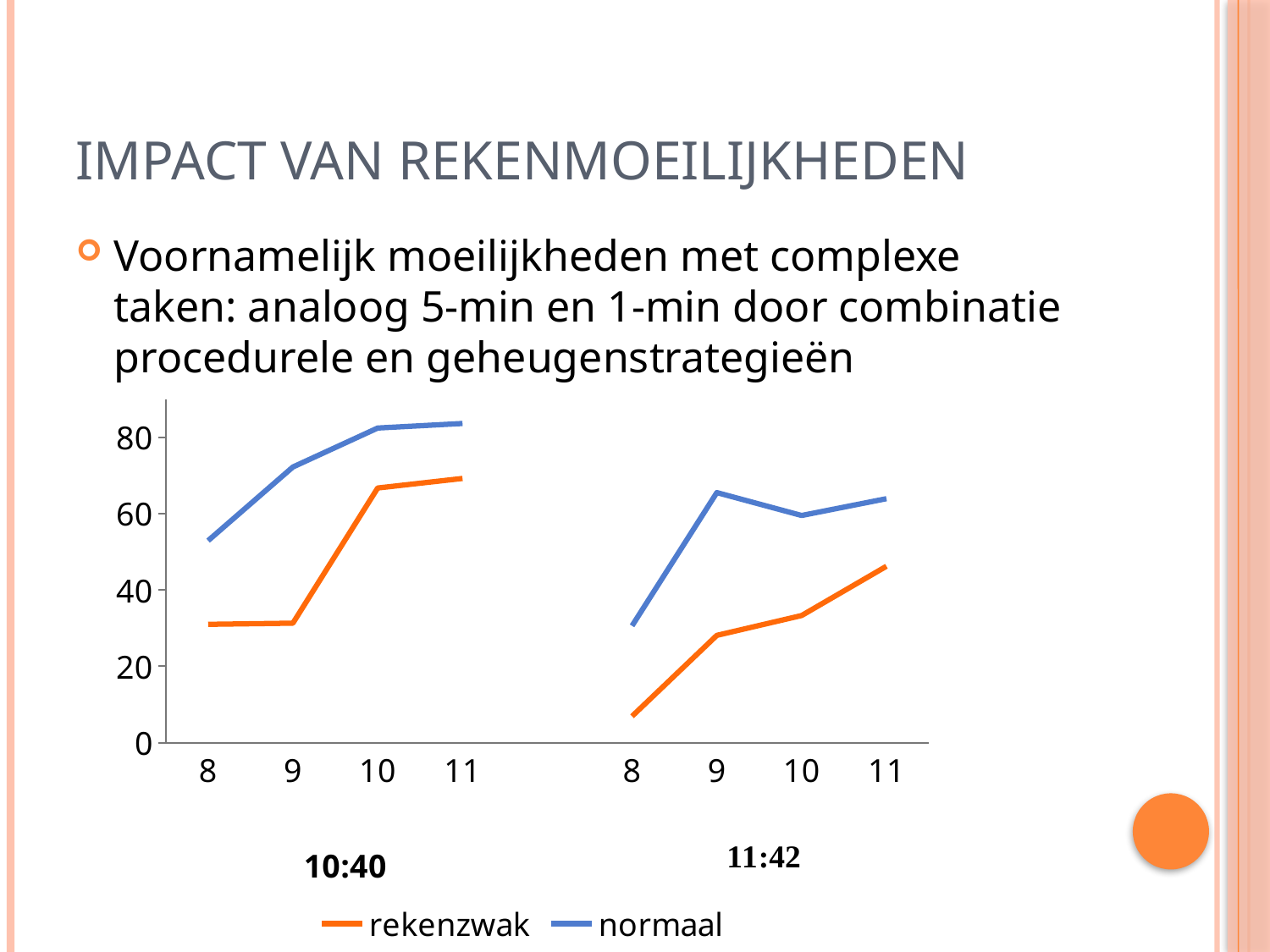
In the 10:40 group, does the normaal line rise or fall from 8 to 11? rise In the 10:40 group, is the value for normaal at 11 greater or less than 80? greater In the 10:40 group, is the value for rekenzwak at 8 greater or less than 20? greater How many series does the legend list? 2 Which two series are listed in the legend? rekenzwak and normaal In the 11:42 group, is the value for rekenzwak at 8 greater or less than 20? less In the 11:42 group, at which x-axis point is the rekenzwak value lowest? 8 How many x-axis points are plotted in the 11:42 group? 4 Which colour is used for the rekenzwak series? orange What kind of chart is shown on the slide? line chart In the 10:40 group, which series has the larger value at 10, rekenzwak or normaal? normaal